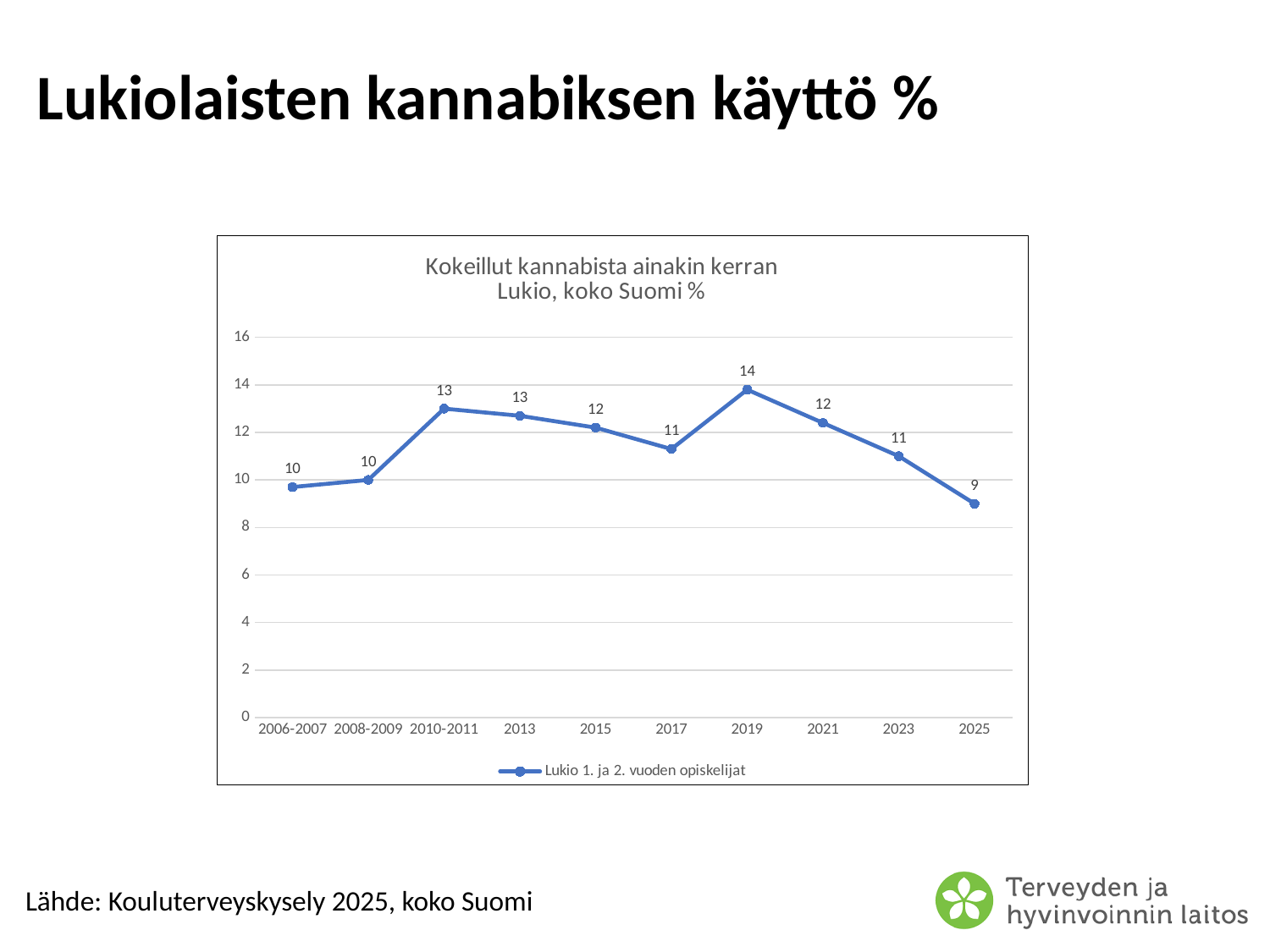
What value is shown for 2025? 9 Which is larger, the value for 2019 or the value for 2021? 2019 How many data points are plotted on the line? 10 Which year has the lowest value? 2025 What is the difference between the values for 2019 and 2025? 5 What value is shown for 2006-2007? 10 Do the values rise or fall from 2019 to 2025? fall Which year has the highest value? 2019 What value is shown for 2019? 14 How many series does the legend list? 1 Is the value for 2017 greater or less than 12? less What kind of chart is shown? line chart